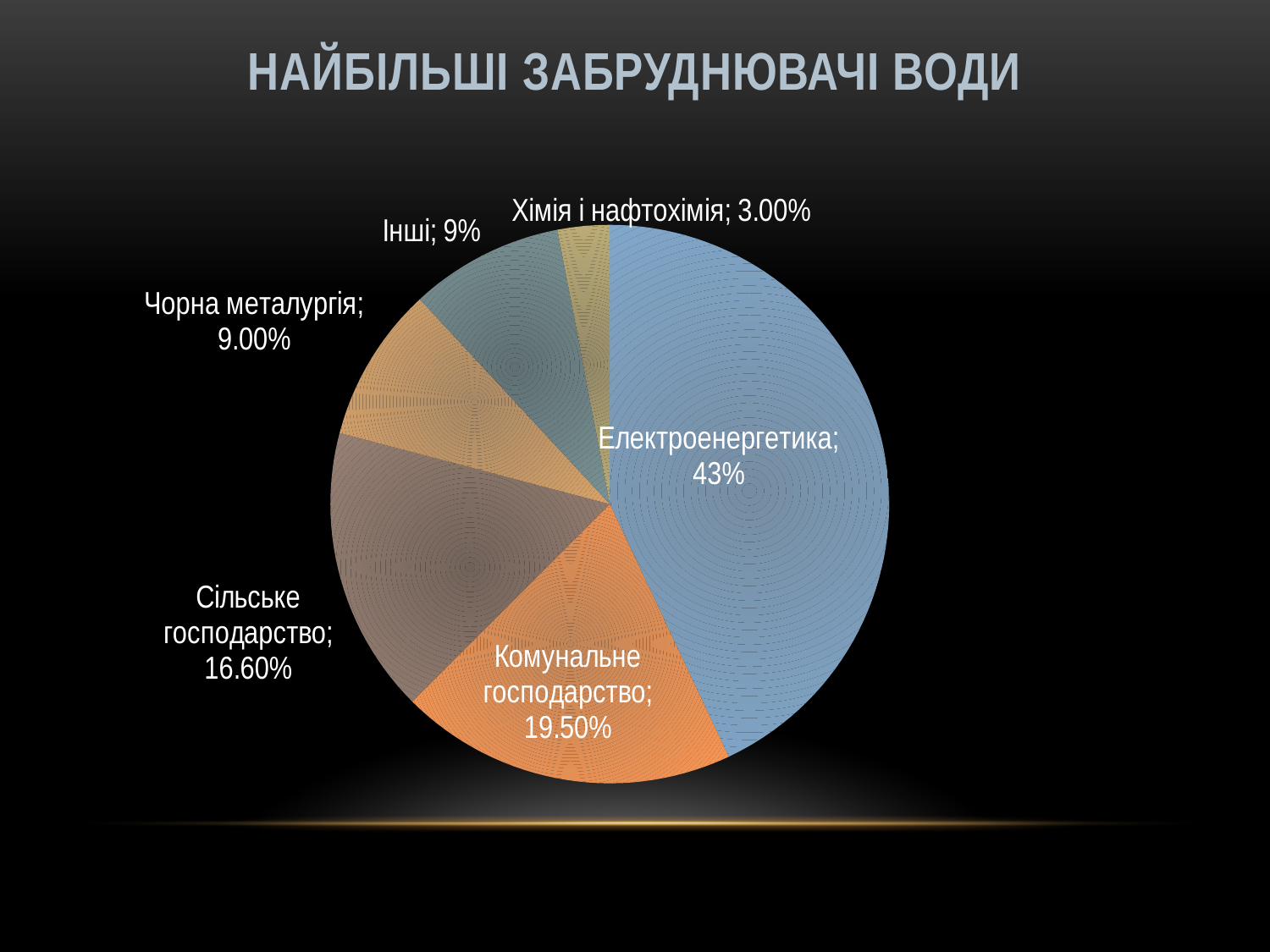
Which is larger, Комунальне господарство or Сільське господарство? Комунальне господарство What is the title of the chart? НАЙБІЛЬШІ ЗАБРУДНЮВАЧІ ВОДИ What is the value shown for Комунальне господарство? 19.50% What is the value shown for Чорна металургія? 9.00% What is the value shown for Хімія і нафтохімія? 3.00% What type of chart is shown on the slide? Pie chart How many slices does the pie chart have? 6 Which category has the largest slice of the pie? Електроенергетика What share of the pie does Електроенергетика have? 43% Which category has the smallest slice of the pie? Хімія і нафтохімія What is the value shown for Сільське господарство? 16.60% What is the difference between the values for Електроенергетика and Комунальне господарство? 23.50%